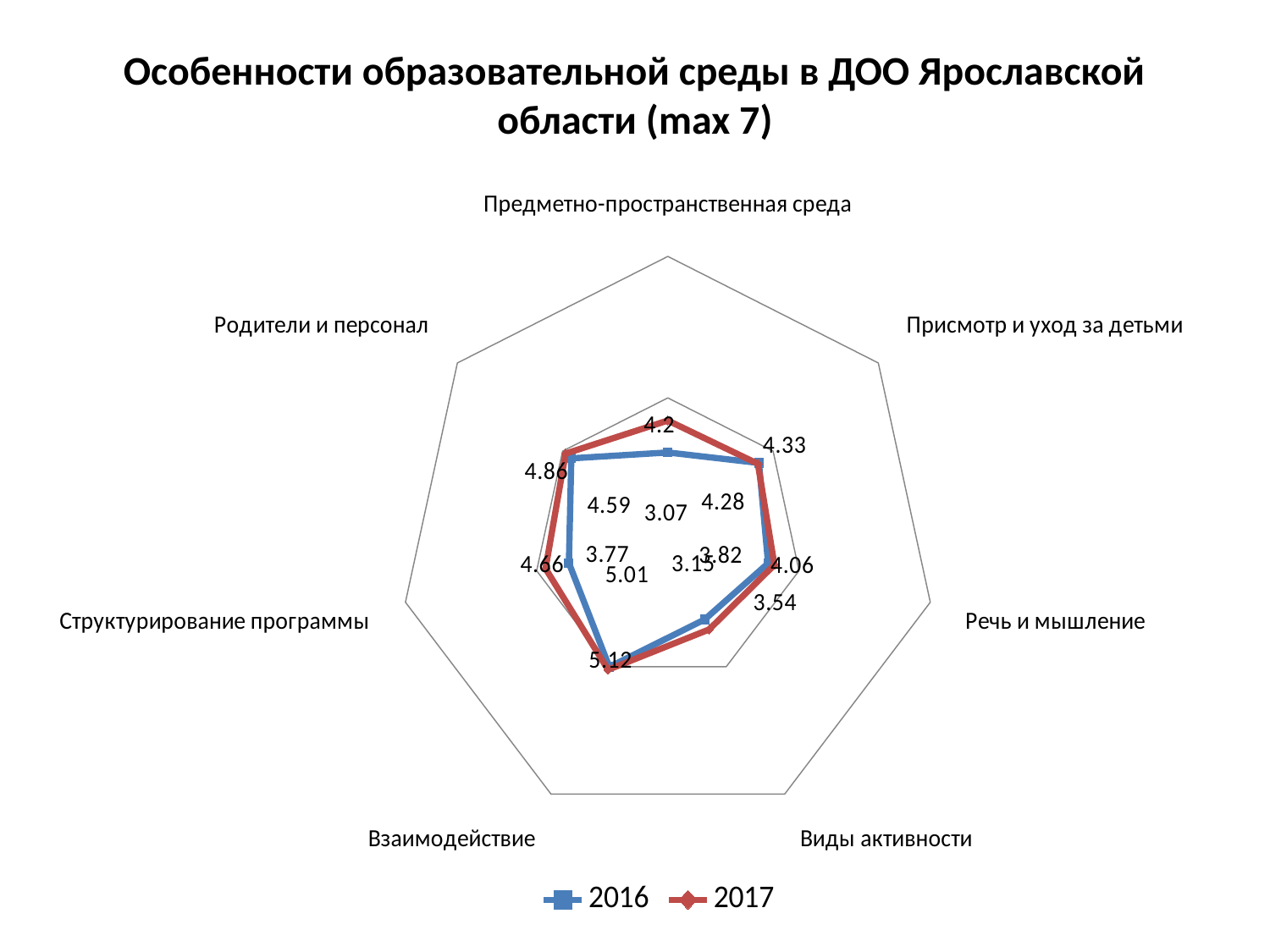
What is the 2017 value for Предметно-пространственная среда? 4.2 For the 2017 series, which category has the highest value? Взаимодействие How many series does the legend list? 2 What is the maximum value stated in the chart title? 7 For the 2017 series, which category has the lowest value? Виды активности In 2017, which is larger: the value for Взаимодействие or the value for Виды активности? Взаимодействие How many categories (axes) does the radar chart have? 7 What is the 2017 value for Взаимодействие? 5.12 What kind of chart is shown on the slide? radar chart What is the difference between the 2017 values for Взаимодействие and Виды активности? 1.58 What is the 2017 value for Виды активности? 3.54 Which years are listed in the chart legend? 2016 and 2017